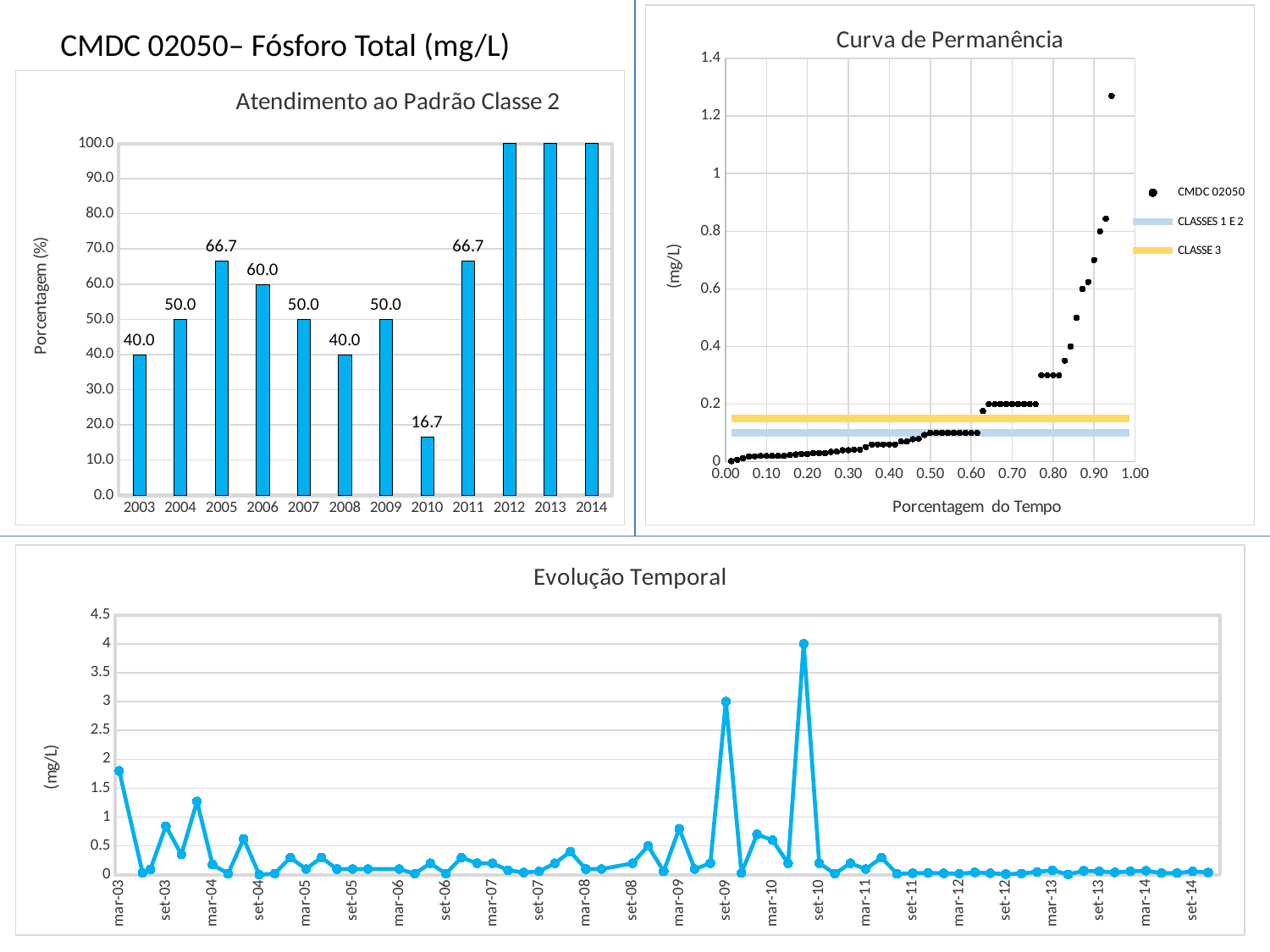
In the 'Atendimento ao Padrão Classe 2' chart, what is the value for 2010? 16.7 In the 'Atendimento ao Padrão Classe 2' chart, is the value for 2013 greater or less than 90.0? greater In the 'Evolução Temporal' chart, is the value at set-09 greater or less than 2.5? greater In the 'Atendimento ao Padrão Classe 2' chart, what is the difference between the values for 2005 and 2010? 50.0 In the 'Atendimento ao Padrão Classe 2' chart, which year has the lowest value? 2010 What kind of chart is 'Evolução Temporal'? line chart What kind of chart is 'Atendimento ao Padrão Classe 2'? bar chart In the 'Atendimento ao Padrão Classe 2' chart, what is the value for 2005? 66.7 What is the x-axis title of the 'Curva de Permanência' chart? Porcentagem do Tempo How many series does the legend of the 'Curva de Permanência' chart list? 3 How many years are shown on the x axis of the 'Atendimento ao Padrão Classe 2' chart? 12 In the 'Atendimento ao Padrão Classe 2' chart, which is larger, the value for 2006 or the value for 2007? 2006